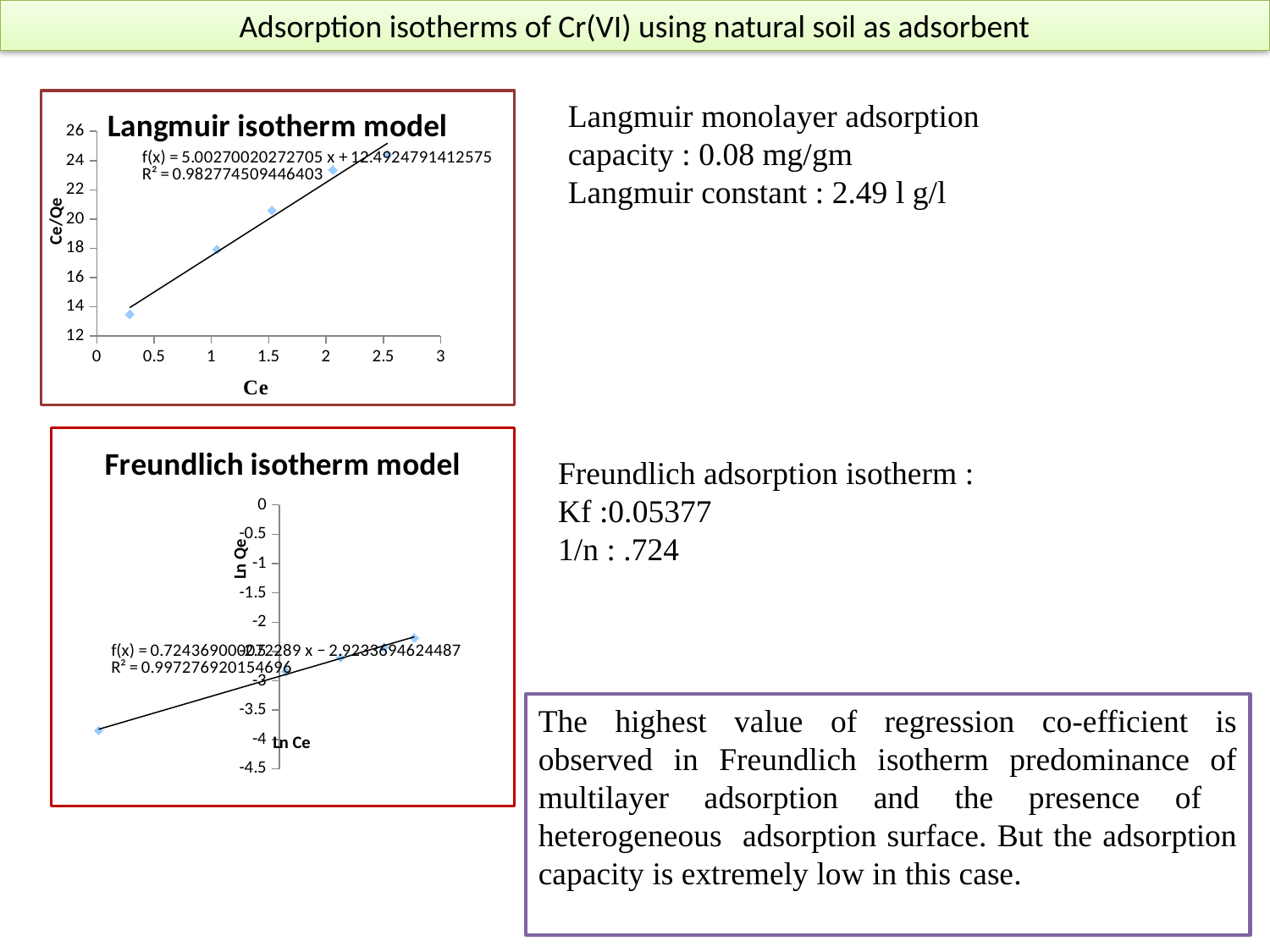
On the Langmuir isotherm model chart, is the Ce/Qe value of the leftmost point greater or less than 14? less What is the label of the x axis on the Langmuir isotherm model chart? Ce How many data points are plotted on the Langmuir isotherm model chart? 5 On the Langmuir isotherm model chart, do the Ce/Qe values rise or fall as Ce increases? rise On the Freundlich isotherm model chart, is the ln Qe value of the lowest point greater or less than -3.5? less What kind of chart is the Freundlich isotherm model chart? scatter chart with a trendline What R² value is printed on the Langmuir isotherm model chart? 0.982774509446403 On the Langmuir isotherm model chart, is the Ce/Qe value of the rightmost point greater or less than 24? greater What kind of chart is the Langmuir isotherm model chart? scatter chart with a trendline How many data points are plotted on the Freundlich isotherm model chart? 5 Which chart shows the higher R² value, the Langmuir isotherm model or the Freundlich isotherm model? Freundlich isotherm model On the Freundlich isotherm model chart, do the ln Qe values rise or fall as ln Ce increases? rise